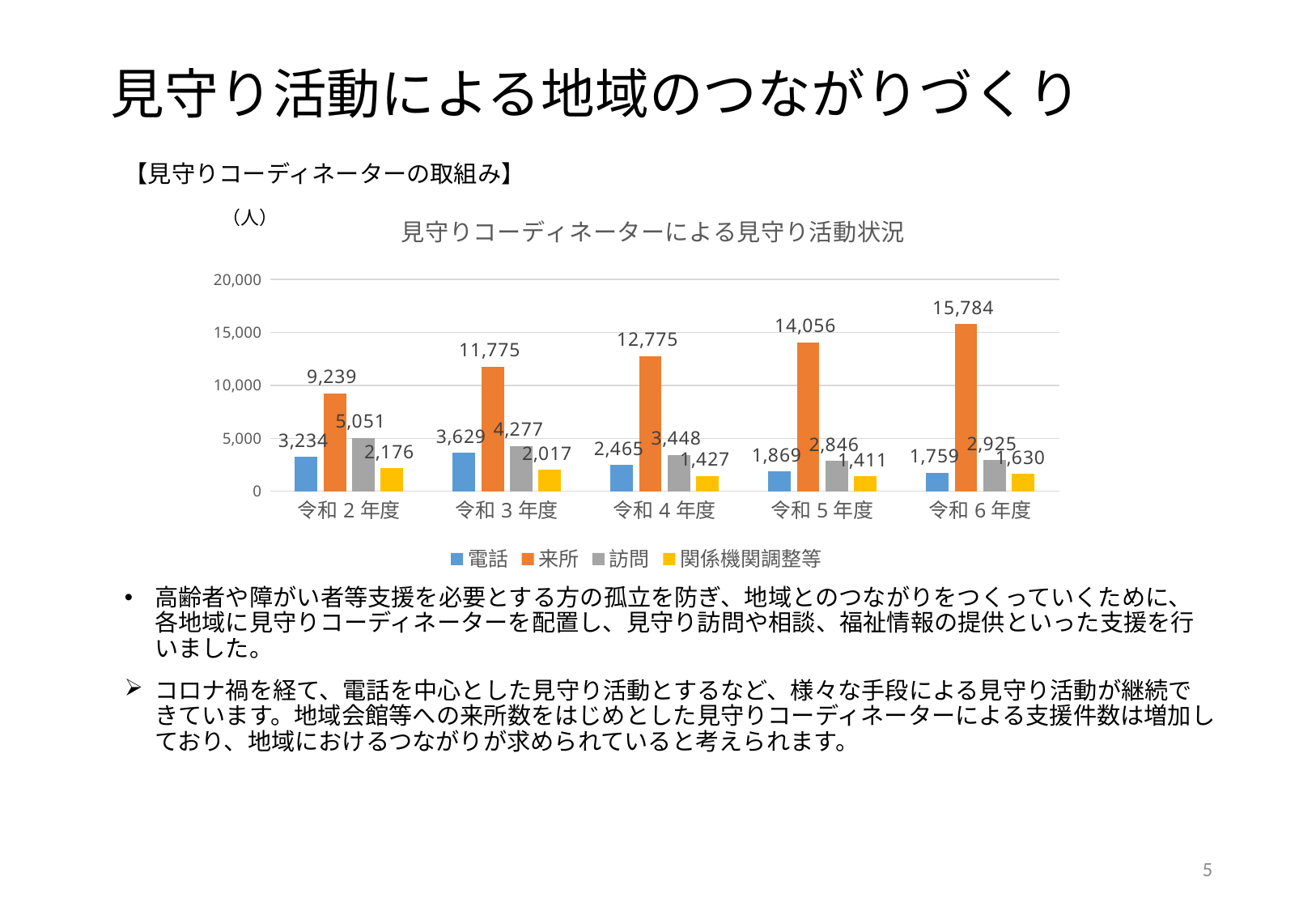
In which year is the value for 電話 the lowest? 令和６年度 Which is larger in 令和３年度: 電話 or 訪問? 訪問 What is the value for 関係機関調整等 in 令和５年度? 1,411 What is the difference between the 来所 values for 令和６年度 and 令和２年度? 6,545 What kind of chart is shown? Bar chart How many series does the legend list? 4 What is the value for 来所 in 令和６年度? 15,784 In which year is the value for 来所 the highest? 令和６年度 What is the value for 電話 in 令和２年度? 3,234 Does the value for 来所 rise or fall from 令和２年度 to 令和６年度? Rise What is the value for 訪問 in 令和４年度? 3,448 How many years are shown on the x axis? 5